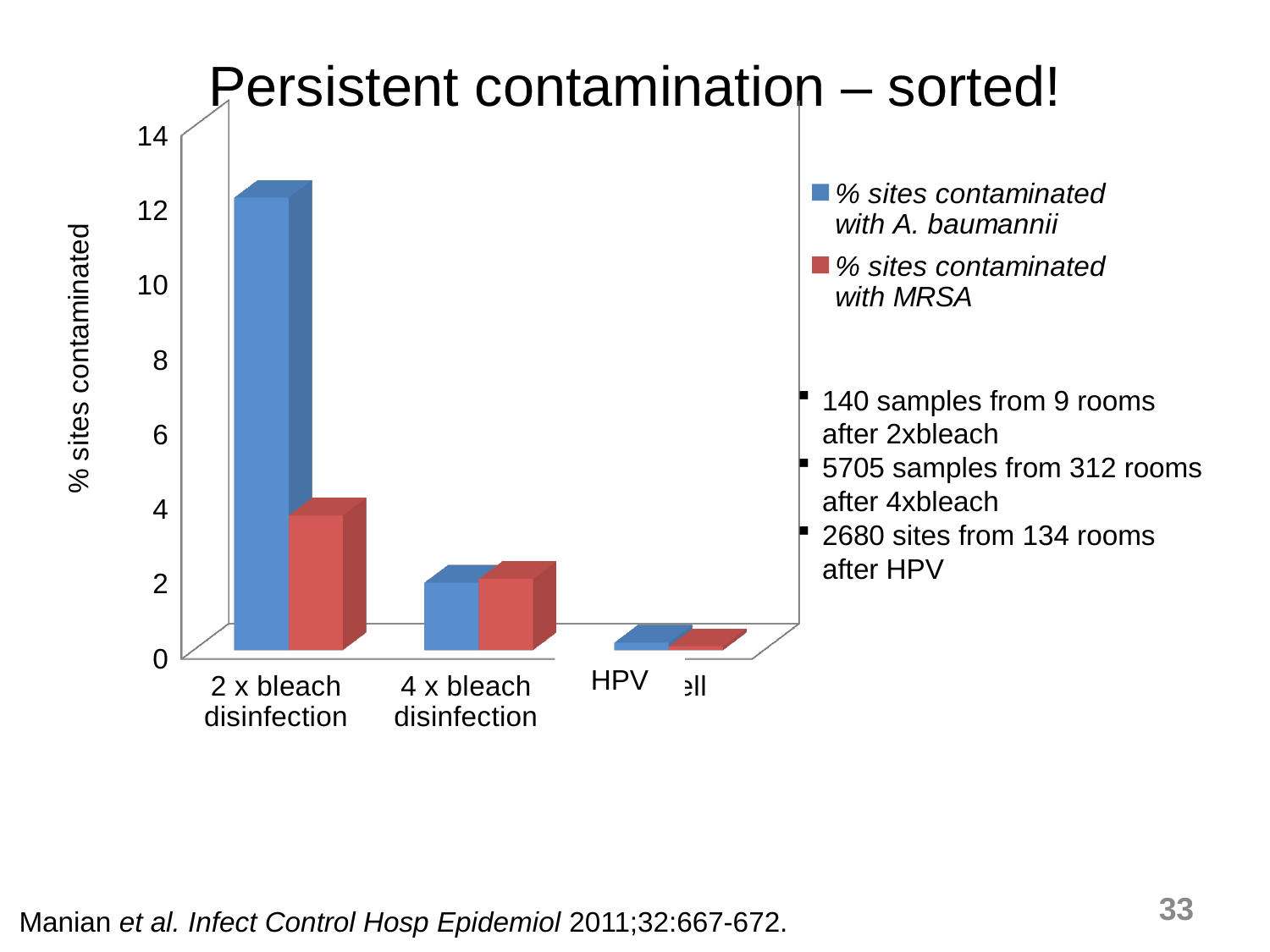
Which disinfection category has the lowest % sites contaminated with A. baumannii? HPV For 2 x bleach disinfection, which is larger: % sites contaminated with A. baumannii or % sites contaminated with MRSA? % sites contaminated with A. baumannii Is the % sites contaminated with A. baumannii for 4 x bleach disinfection greater or less than 4? less Which disinfection category has the highest % sites contaminated with A. baumannii? 2 x bleach disinfection Do the % sites contaminated with A. baumannii values rise or fall from 2 x bleach disinfection to HPV along the x axis? fall How many series does the chart legend list? 2 Is the % sites contaminated with A. baumannii for 2 x bleach disinfection greater or less than 10? greater Is the % sites contaminated with MRSA for 2 x bleach disinfection greater or less than 2? greater How many disinfection categories are shown on the x axis of the chart? 3 What kind of chart is shown on the slide? bar chart What colour represents % sites contaminated with MRSA in the chart? red Which disinfection category has the highest % sites contaminated with MRSA? 2 x bleach disinfection